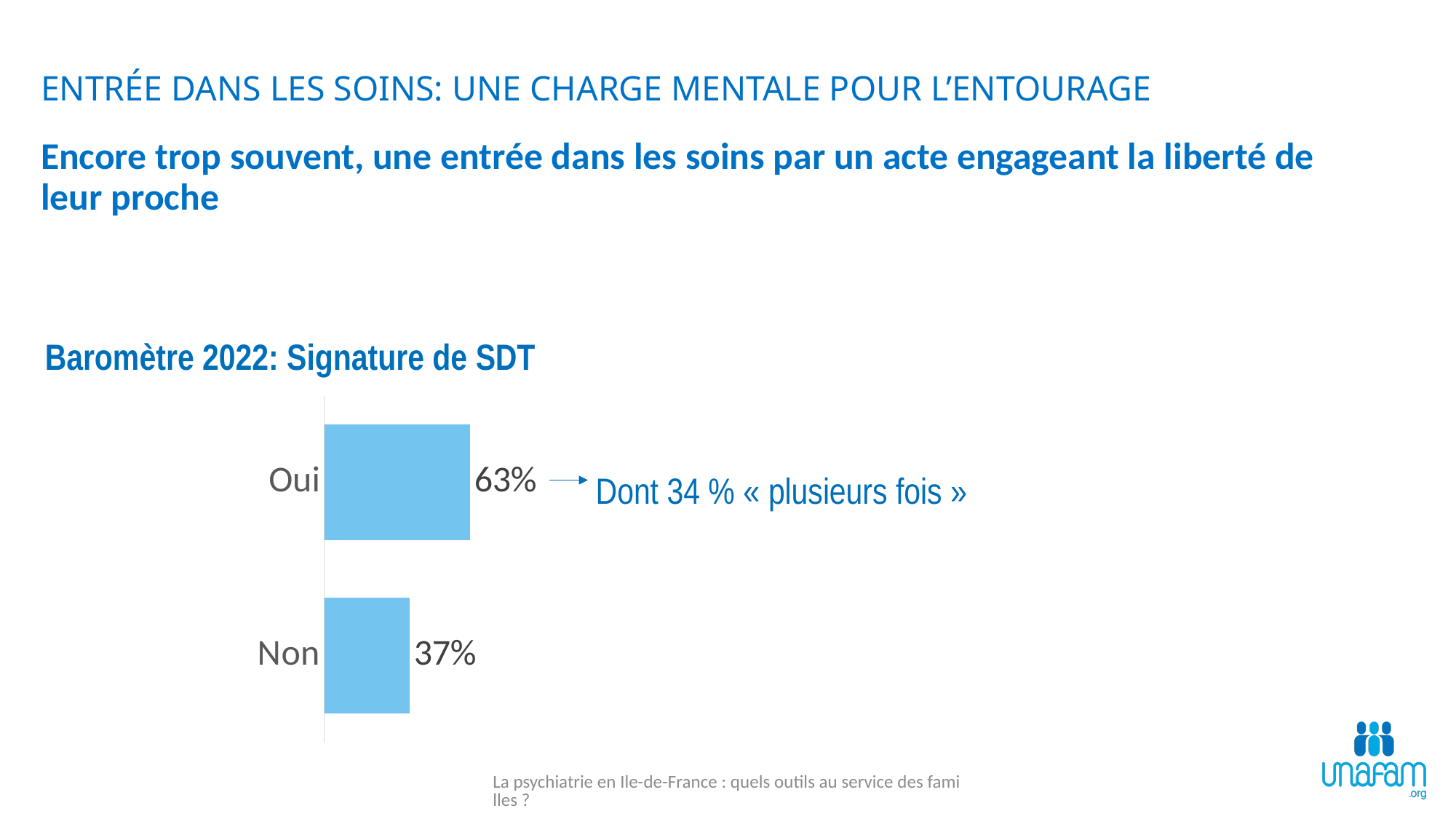
What is the total of the values for "Oui" and "Non"? 100% What kind of chart is shown on the slide? Bar chart Which is larger, the value for "Oui" or the value for "Non"? Oui What is the value for "Non"? 37% How many categories are shown in the chart? 2 What is the value for "Oui"? 63% According to the annotation next to the "Oui" bar, what share answered "plusieurs fois"? 34 % Which category has the highest value? Oui What is the difference between the values for "Oui" and "Non"? 26% What is the title of the chart? Baromètre 2022: Signature de SDT Which category has the lowest value? Non